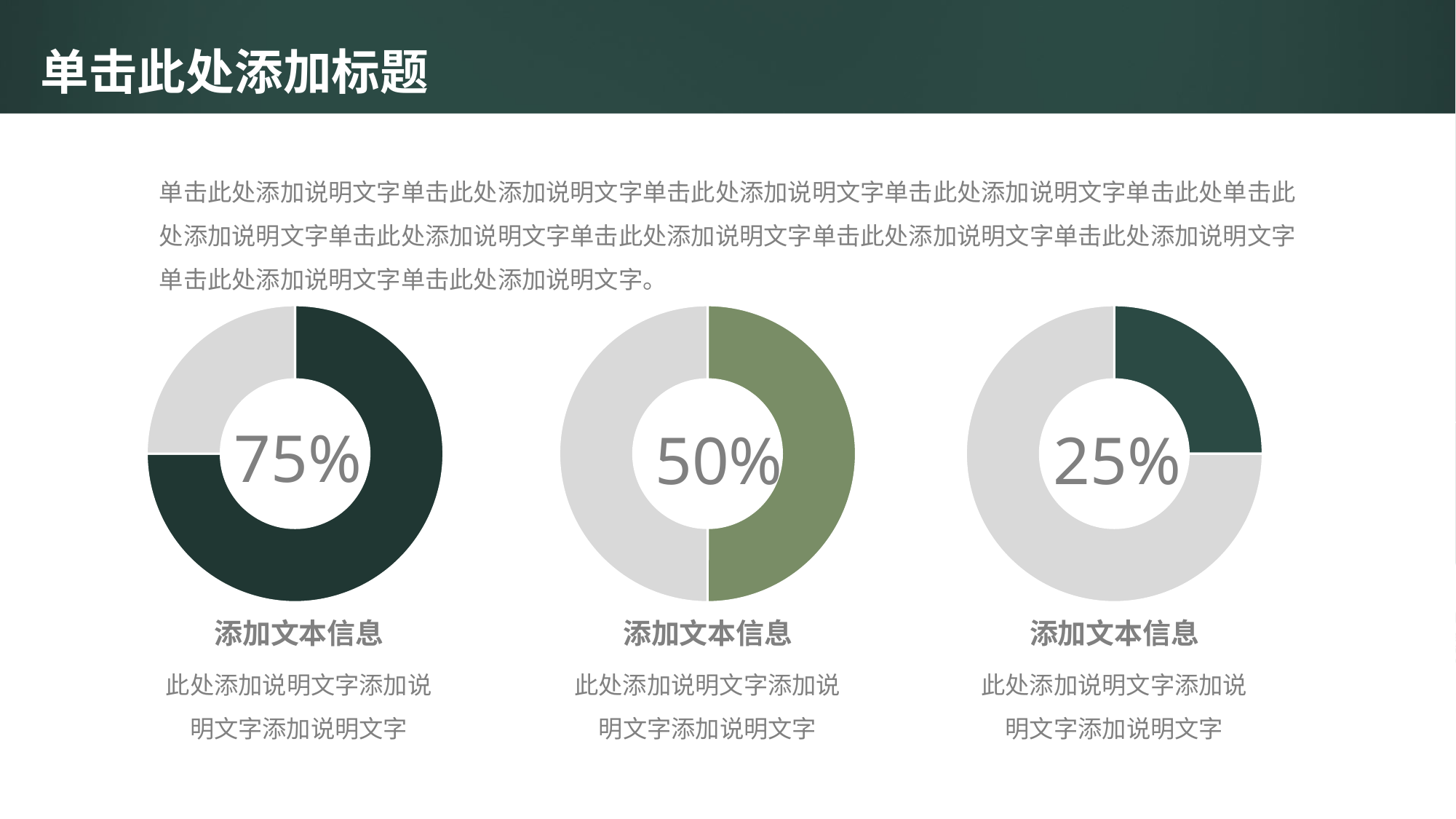
What colour is the filled segment of the middle donut chart? Light green What percentage is shown in the centre of the middle donut chart? 50% What is the difference between the percentage in the left donut chart and the percentage in the right donut chart? 50% What is the difference between the percentage in the middle donut chart and the percentage in the right donut chart? 25% What percentage is shown in the centre of the right donut chart? 25% What kind of chart is used for the three figures on the slide? Donut chart What percentage is shown in the centre of the left donut chart? 75% How many donut charts are on the slide? 3 What share of the middle donut chart is filled with the coloured (green) segment? 50% Which is larger, the percentage in the middle donut chart or the percentage in the right donut chart? The middle chart (50%) Which of the three donut charts shows the lowest percentage? The right chart (25%) Which of the three donut charts shows the highest percentage? The left chart (75%)